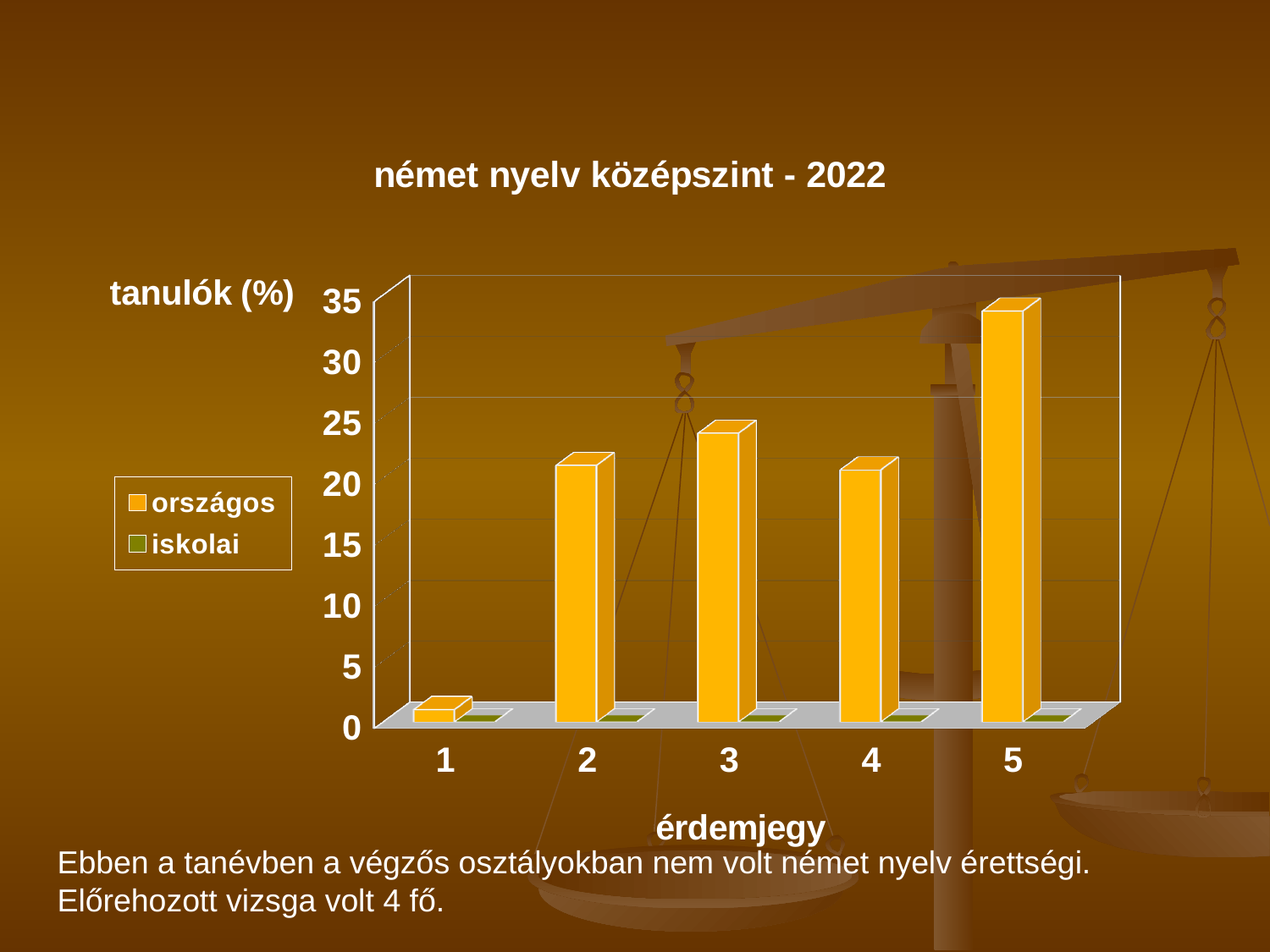
How many series does the legend list? 2 Which is larger for the országos series: the value for érdemjegy 3 or érdemjegy 2? érdemjegy 3 Which series are listed in the legend? országos, iskolai How many érdemjegy categories are shown on the x axis? 5 Which is larger for the országos series: the value for érdemjegy 5 or érdemjegy 4? érdemjegy 5 Is the országos value for érdemjegy 5 greater or less than 30? greater For the országos series, which érdemjegy has the lowest value? 1 What is the title of the chart? német nyelv középszint - 2022 Is the országos value for érdemjegy 3 greater or less than 20? greater For the országos series, which érdemjegy has the highest value? 5 What kind of chart is shown on the slide? bar chart Is the országos value for érdemjegy 1 greater or less than 5? less